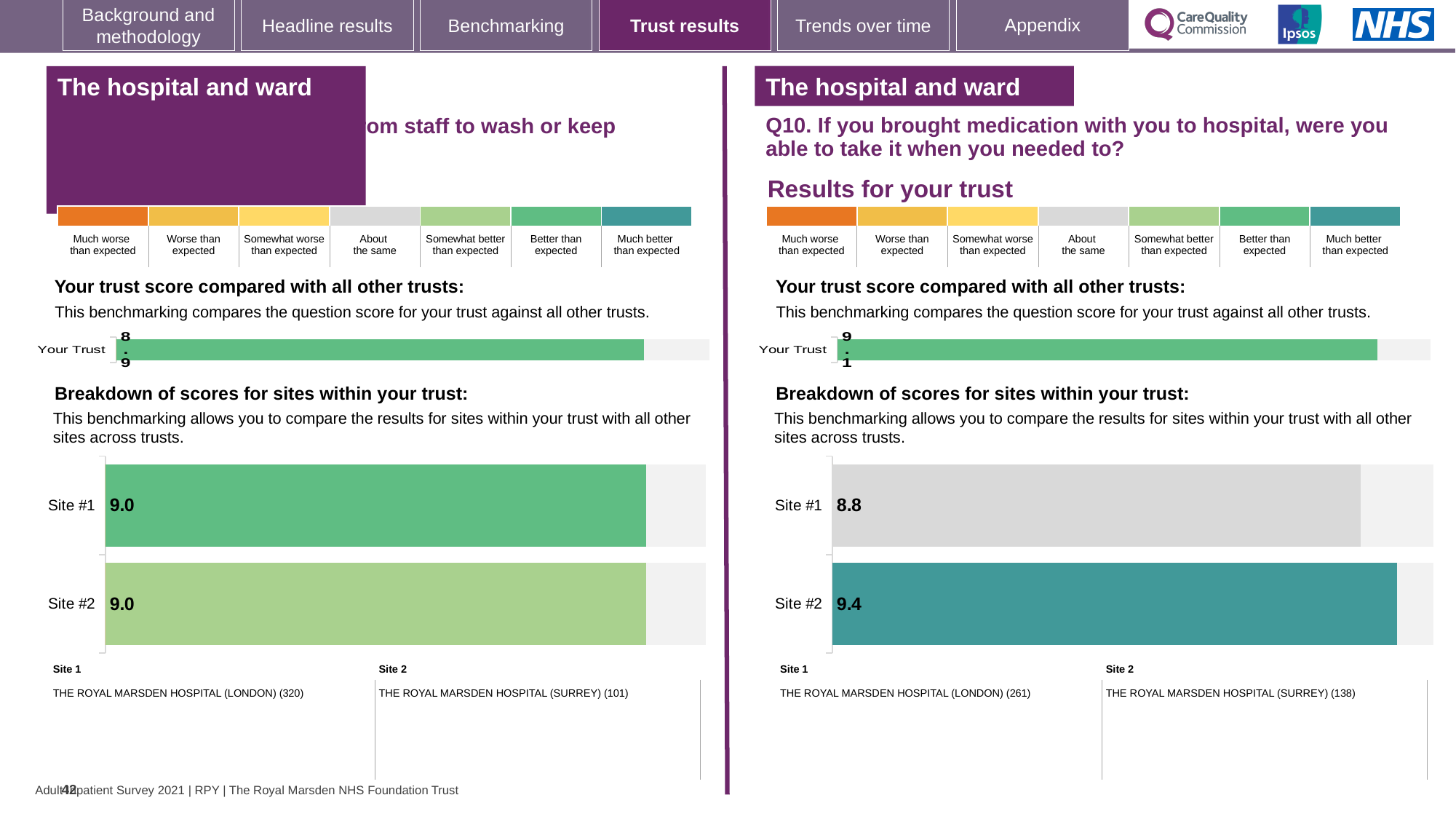
On the right-hand chart (Q10, medication), which site has the higher score, Site #1 or Site #2? Site #2 On the left-hand chart, what is the difference between the Site #1 and Site #2 scores? 0.0 On the left-hand chart, what is the score for Site #1? 9.0 On the right-hand chart (Q10, medication), what is the difference between the Site #2 and Site #1 scores? 0.6 On the right-hand side (Q10), which hospital is Site 2? THE ROYAL MARSDEN HOSPITAL (SURREY) On the right-hand chart (Q10, medication), what is the score for Site #1? 8.8 On the right-hand chart (Q10, medication), what is the 'Your Trust' score? 9.1 What type of chart is used to show the breakdown of scores for sites on the right-hand side (Q10)? Bar chart How many sites are shown in the site breakdown chart on the right-hand side (Q10)? 2 On the left-hand chart, what is the 'Your Trust' score? 8.9 On the right-hand chart (Q10, medication), which site has the lowest score? Site #1 On the right-hand chart (Q10, medication), what is the score for Site #2? 9.4